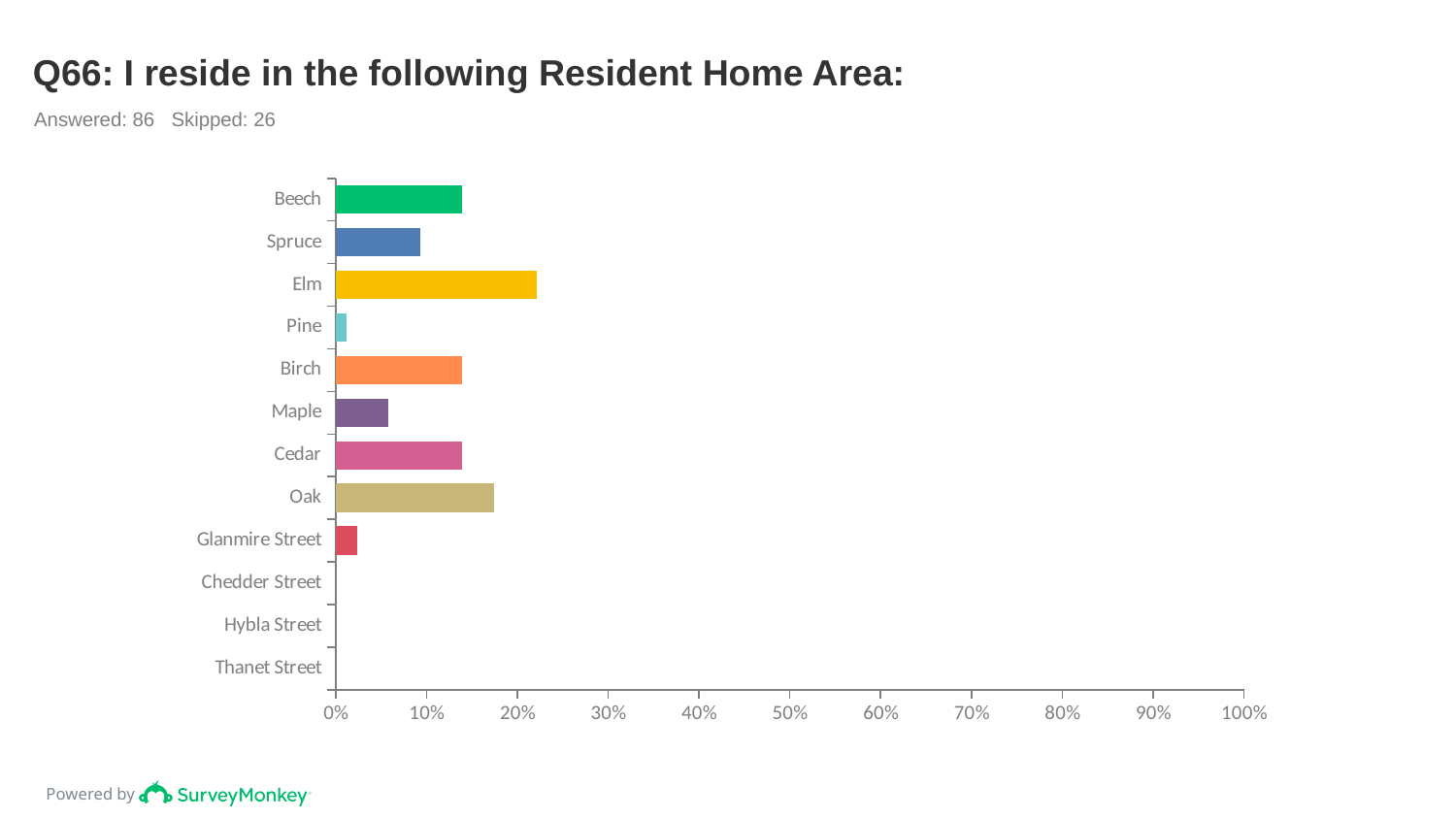
Which resident home area has the highest percentage? Elm Which is larger, the value for Elm or the value for Oak? Elm Is the value for Elm greater or less than 20%? greater Which is larger, the value for Oak or the value for Cedar? Oak Is the value for Beech greater or less than 10%? greater How many resident home area categories are listed on the chart? 12 Which is larger, the value for Spruce or the value for Maple? Spruce Is the value for Maple greater or less than 10%? less What kind of chart is shown on the slide? Bar chart What is the title of the chart? Q66: I reside in the following Resident Home Area: